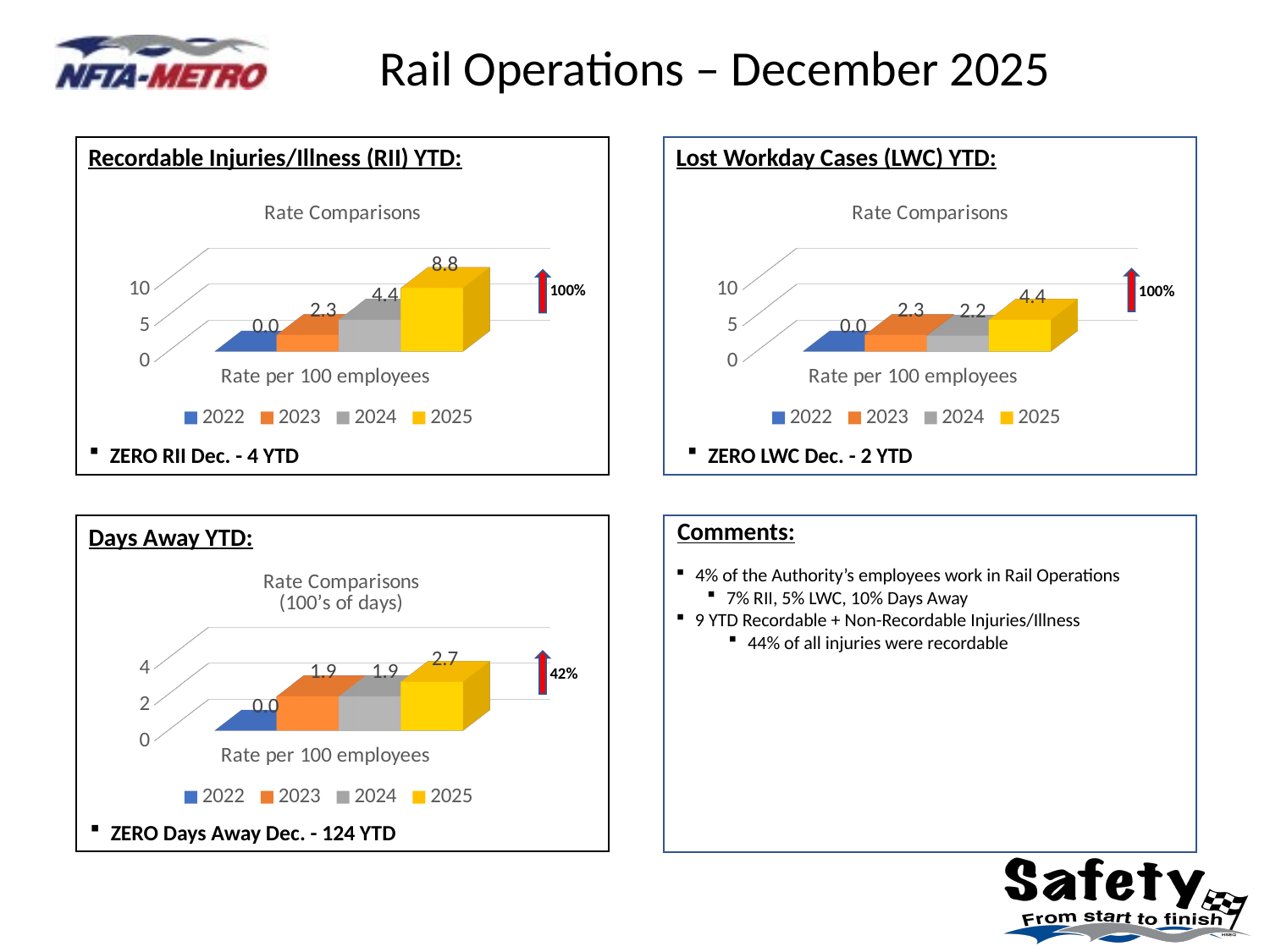
In the Recordable Injuries/Illness (RII) YTD chart, what is the value for 2025? 8.8 In the Recordable Injuries/Illness (RII) YTD chart, which year has the highest rate? 2025 In the Days Away YTD chart, what is the difference between the 2025 and 2024 values? 0.8 In the Days Away YTD chart, which is larger, the value for 2023 or the value for 2025? 2025 In the Lost Workday Cases (LWC) YTD chart, is the value for 2025 greater or less than 5? less How many series does the legend of the Days Away YTD chart list? 4 In the Lost Workday Cases (LWC) YTD chart, what is the value for 2024? 2.2 In the Days Away YTD chart, what is the value for 2025? 2.7 In the Recordable Injuries/Illness (RII) YTD chart, what is the difference between the 2025 and 2024 values? 4.4 What kind of chart is the Recordable Injuries/Illness (RII) YTD chart? Bar chart What is the x-axis label shown on the Lost Workday Cases (LWC) YTD chart? Rate per 100 employees In the Lost Workday Cases (LWC) YTD chart, which year has the lowest rate? 2022